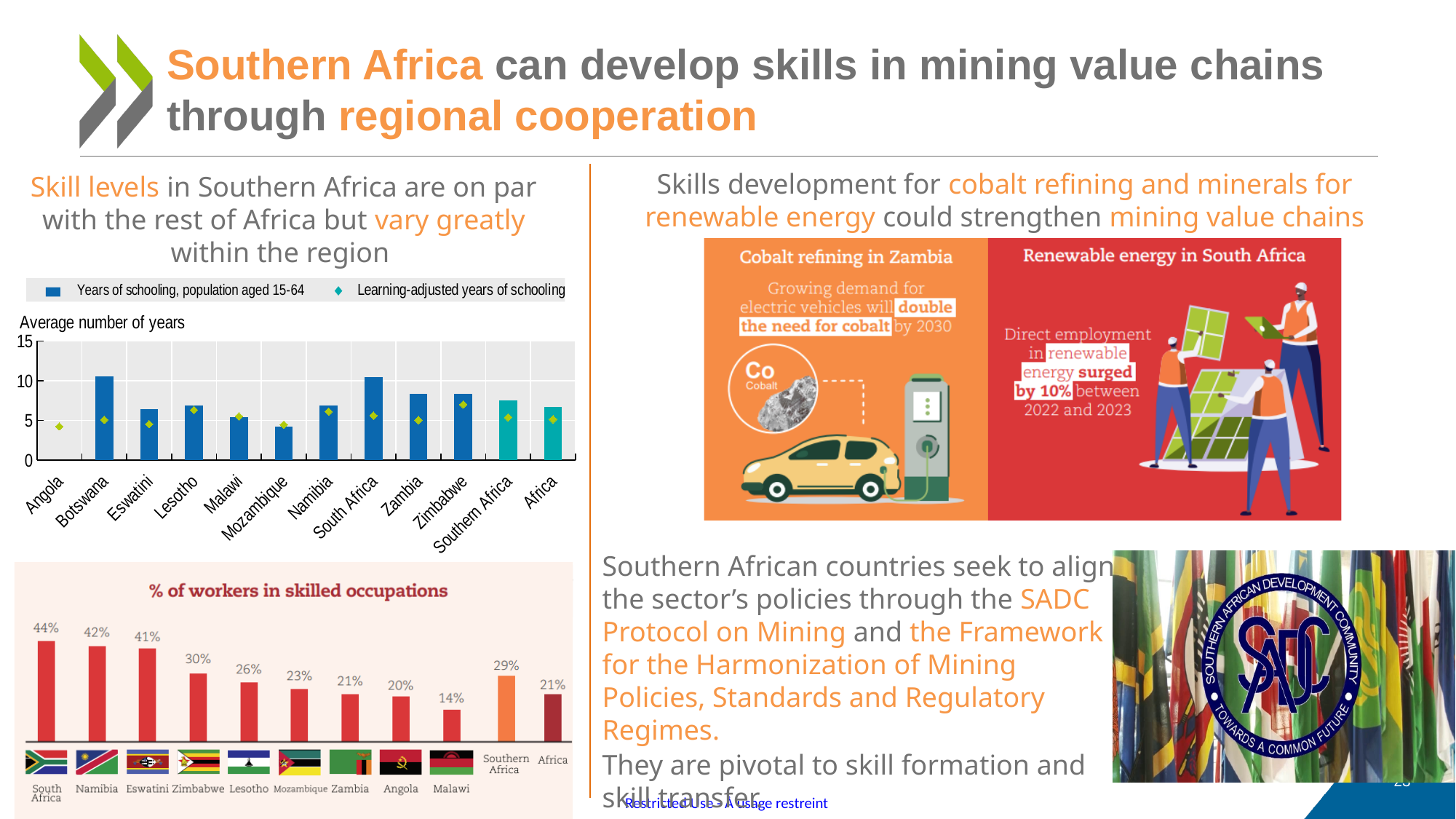
In the '% of workers in skilled occupations' chart, what is the difference between South Africa and Malawi? 30 percentage points What kind of chart is the '% of workers in skilled occupations' chart? Bar chart How many series does the legend of the 'Average number of years' chart list? 2 How many categories are shown on the x axis of the 'Average number of years' chart? 12 In the '% of workers in skilled occupations' chart, what is the value for South Africa? 44% How many bars are shown in the '% of workers in skilled occupations' chart? 11 In the '% of workers in skilled occupations' chart, what is the value for Malawi? 14% In the '% of workers in skilled occupations' chart, which country has the lowest value? Malawi In the '% of workers in skilled occupations' chart, which country has the highest value? South Africa In the '% of workers in skilled occupations' chart, which is larger, Southern Africa or Africa? Southern Africa In the 'Average number of years' chart, is the years of schooling bar for Mozambique greater or less than 5? less In the '% of workers in skilled occupations' chart, what is the value for Southern Africa? 29%